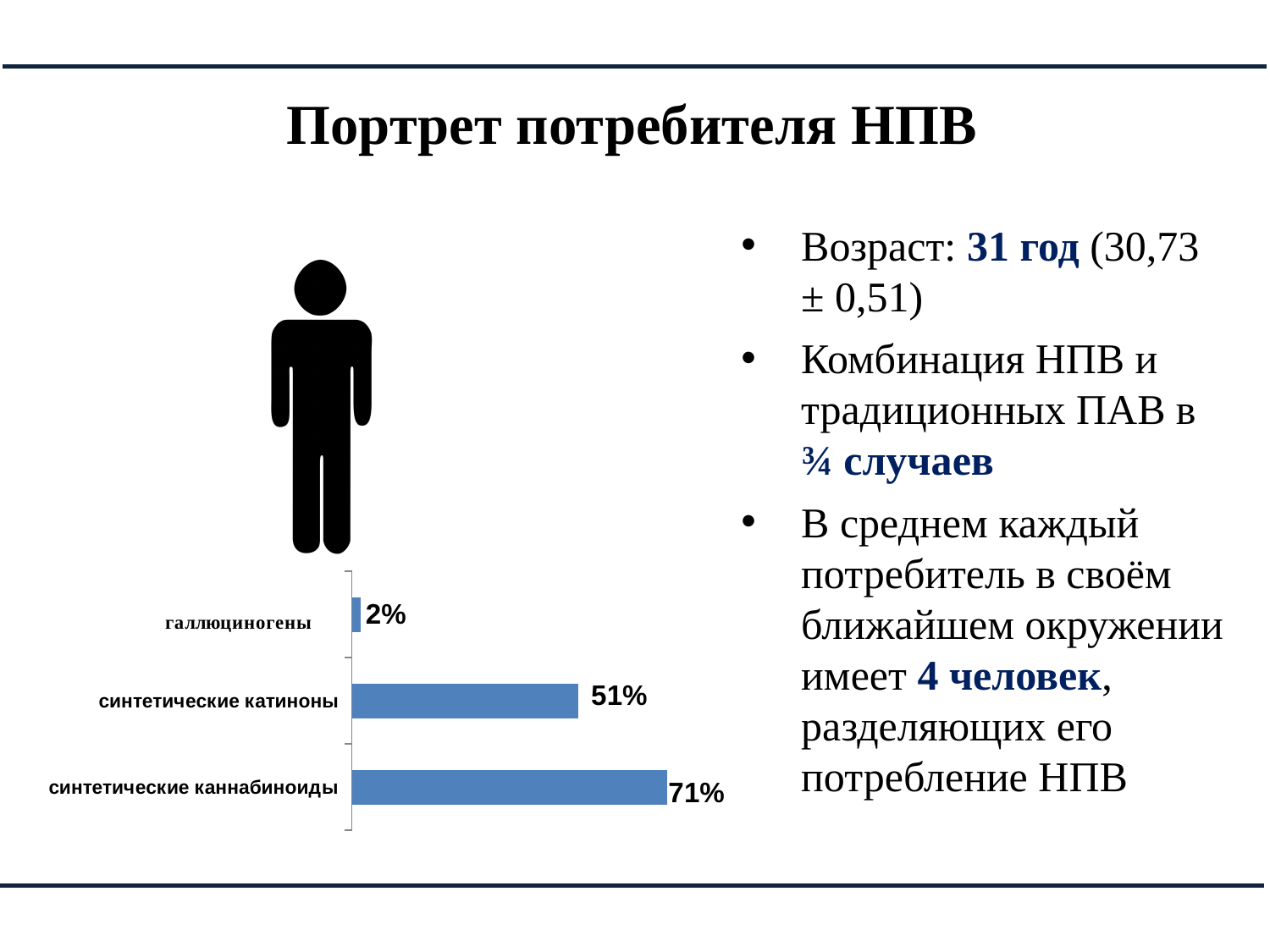
What is the value for синтетические катиноны? 51% Which category has the highest value? синтетические каннабиноиды What colour are the bars in the chart? blue How many categories are shown in the chart? 3 Are the bars in the chart horizontal or vertical? horizontal What is the difference between the values for синтетические каннабиноиды and синтетические катиноны? 20% What kind of chart is shown on the slide? bar chart What is the difference between the values for синтетические катиноны and галлюциногены? 49% Which category has the lowest value? галлюциногены What is the value for галлюциногены? 2% What is the value for синтетические каннабиноиды? 71% Which is larger, the value for синтетические катиноны or the value for галлюциногены? синтетические катиноны